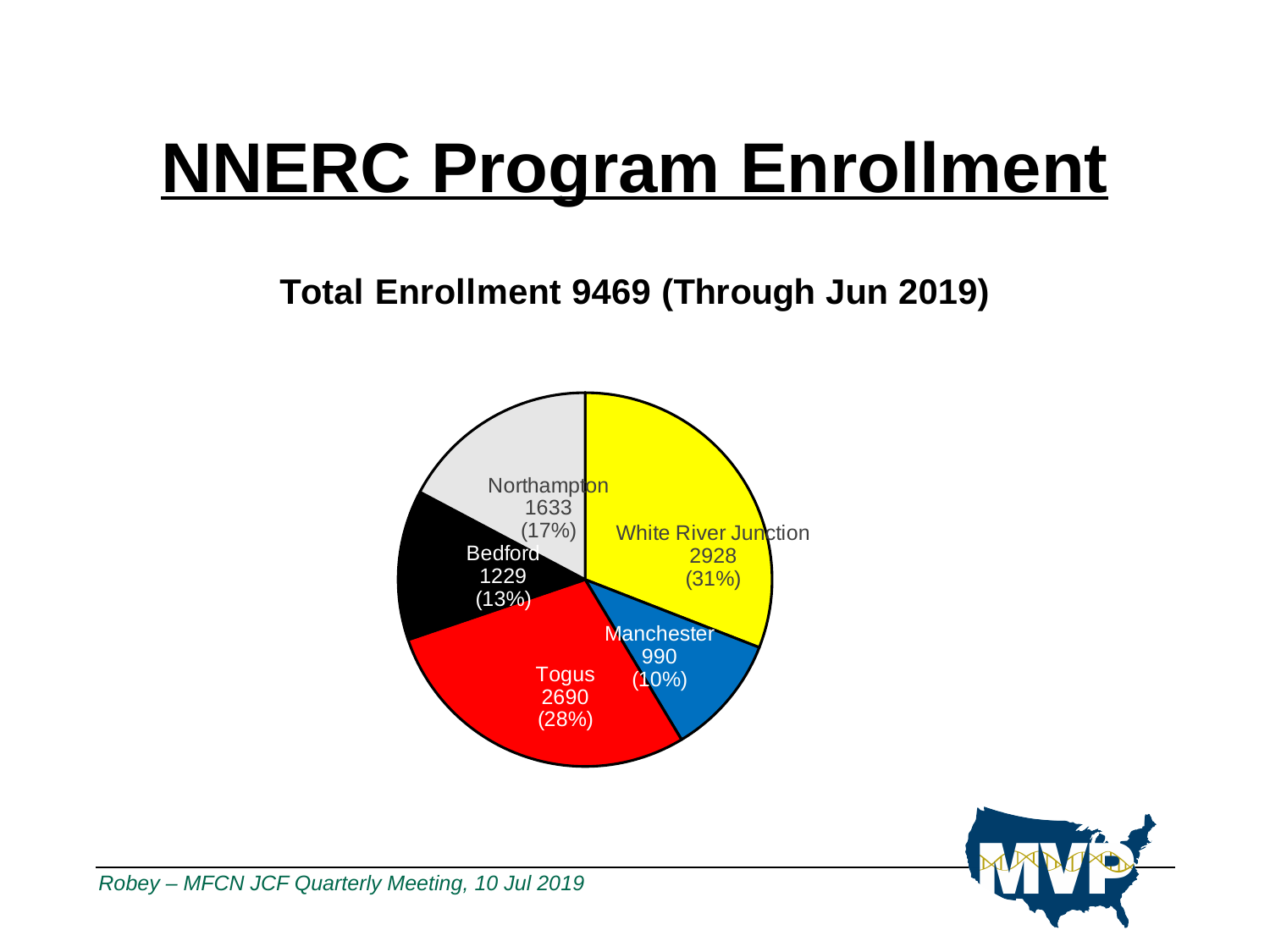
What is the enrollment for White River Junction? 2928 What kind of chart is shown on the slide? Pie chart What is the enrollment for Togus? 2690 What is the enrollment for Bedford? 1229 Which site has the lowest enrollment? Manchester What share of total enrollment does Northampton represent? 17% Which site has the highest enrollment? White River Junction Which has the larger enrollment, Northampton or Bedford? Northampton What is the enrollment for Manchester? 990 What is the difference in enrollment between White River Junction and Togus? 238 What colour is the Togus slice? Red How many sites are shown in the pie chart? 5